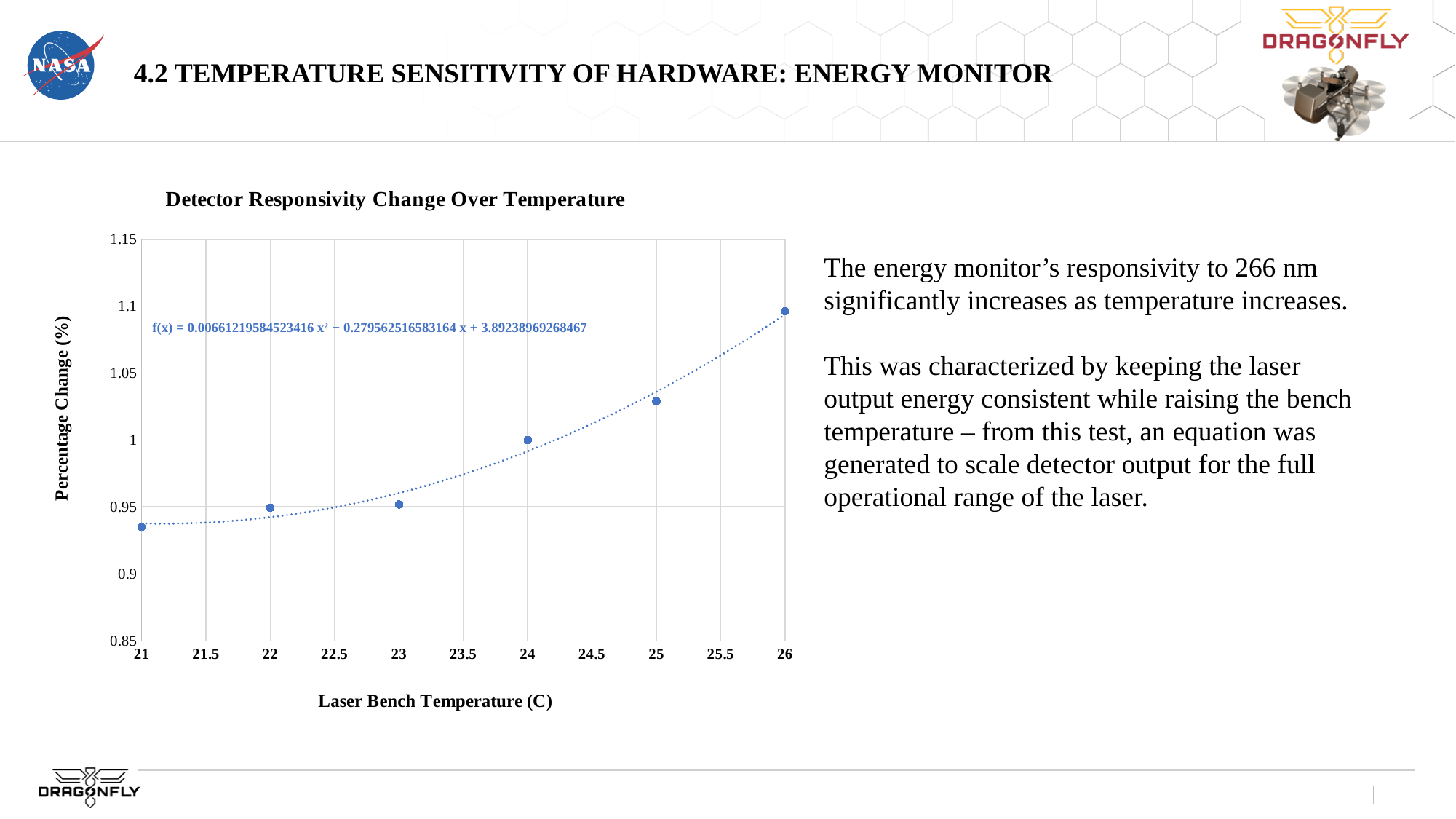
At which laser bench temperature is the percentage change highest? 26 Is the percentage change at 25 C greater or less than 1? greater What is the label of the x axis? Laser Bench Temperature (C) Which has a larger percentage change, 22 C or 25 C? 25 C What type of chart is shown on the slide? Scatter chart Is the percentage change at 26 C greater or less than 1.05? greater What is the title of the chart? Detector Responsivity Change Over Temperature How many data points are plotted in the chart? 6 What is the percentage change value at a laser bench temperature of 24 C? 1 At which laser bench temperature is the percentage change lowest? 21 Is the percentage change at 21 C greater or less than 0.95? less Do the percentage change values rise or fall as laser bench temperature increases? Rise